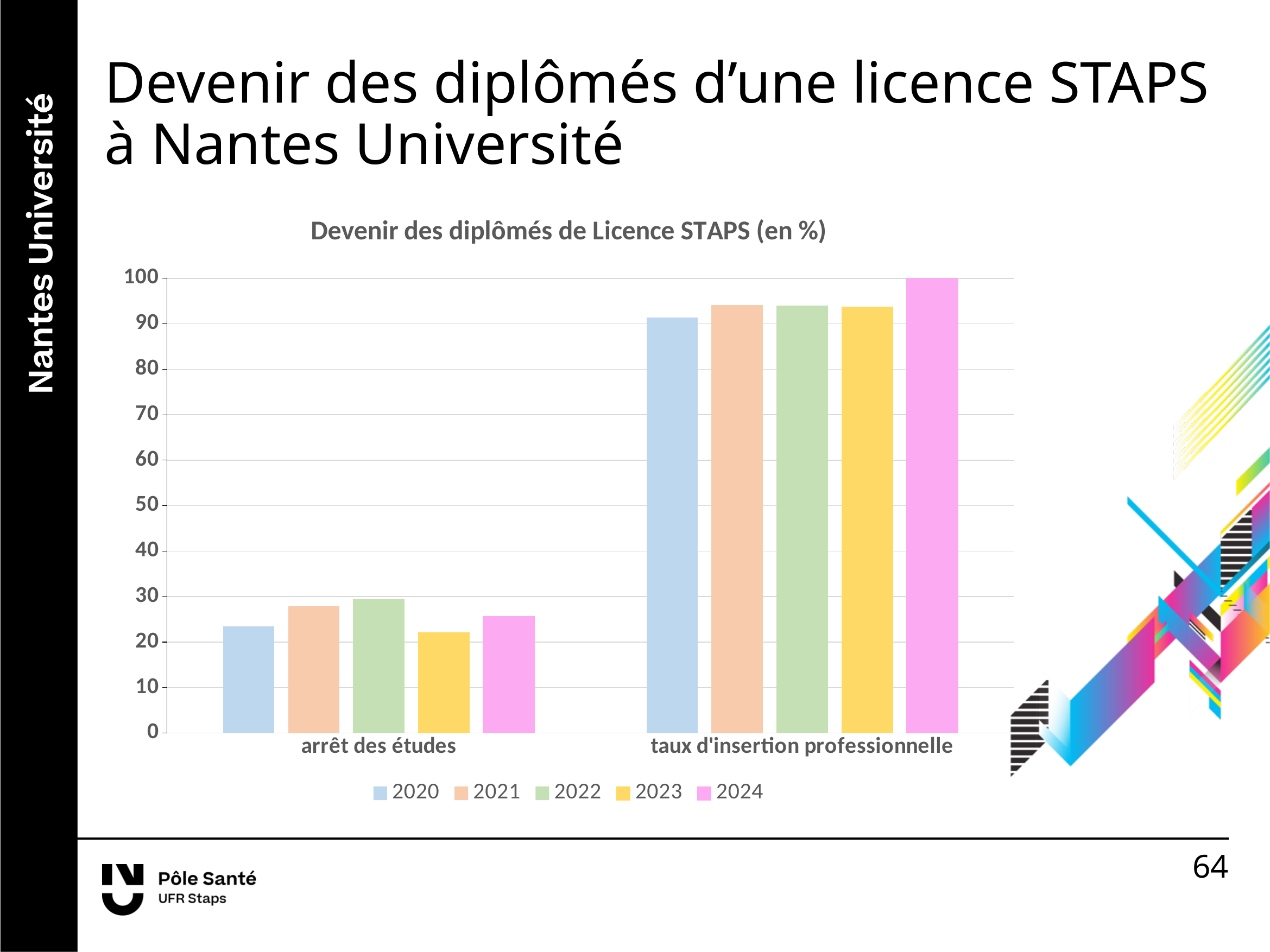
In the 'arrêt des études' category, which is larger: the value for 2021 or the value for 2023? 2021 Which year has the highest value for 'taux d'insertion professionnelle'? 2024 How many categories are shown on the x axis? 2 Which years are listed in the legend? 2020, 2021, 2022, 2023, 2024 What kind of chart is shown on the slide? bar chart Which year has the lowest value for 'taux d'insertion professionnelle'? 2020 What is the title of the chart? Devenir des diplômés de Licence STAPS (en %) What is the value for 2024 in the 'taux d'insertion professionnelle' category? 100 Is the value for 2020 in 'taux d'insertion professionnelle' greater or less than 90? greater Is the value for 2023 in 'arrêt des études' greater or less than 20? greater How many series does the legend list? 5 Is the value for 2020 in 'arrêt des études' greater or less than 30? less